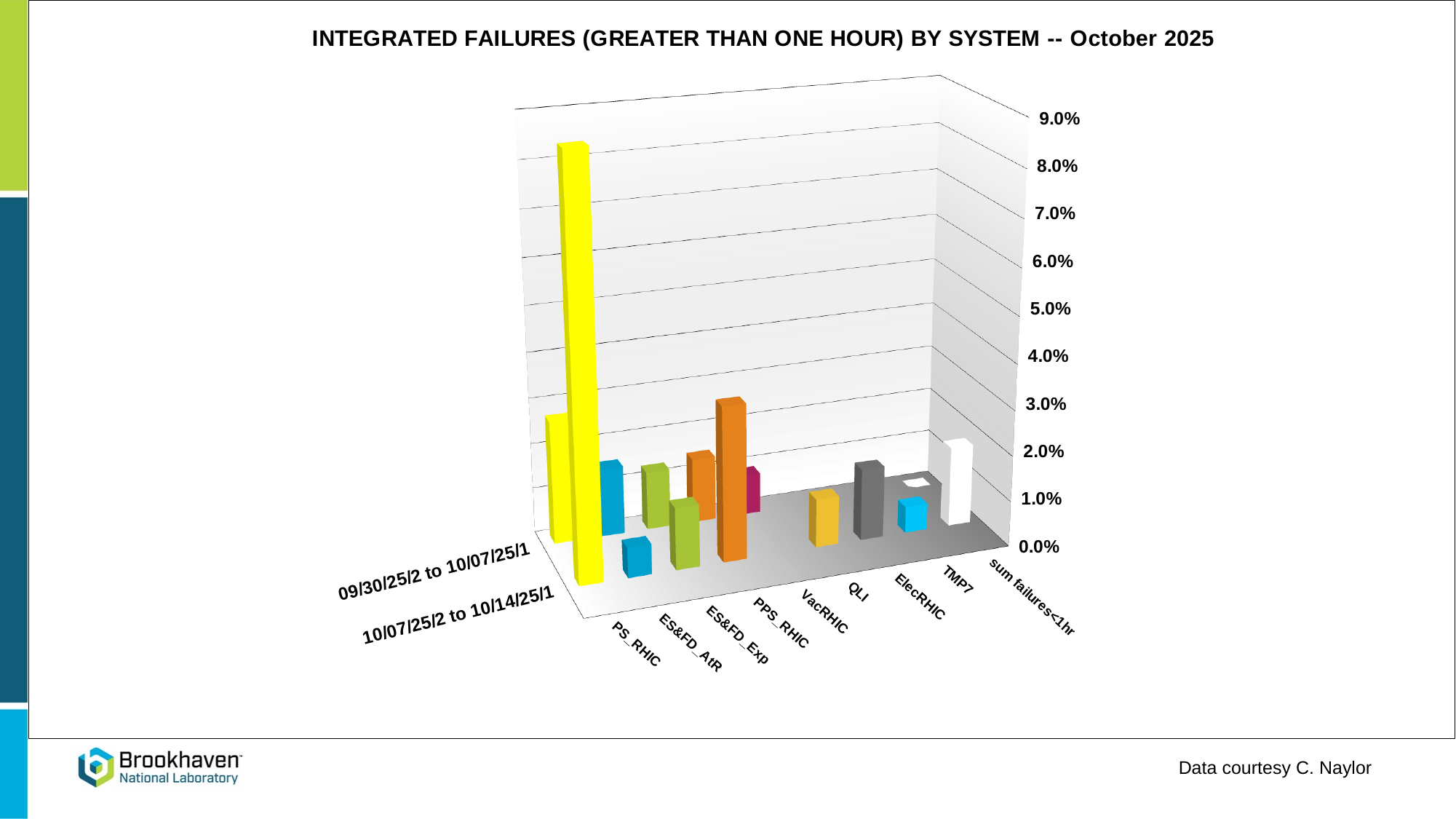
Which system has the tallest bar in the chart? PS_RHIC How many weekly periods (rows) are plotted in the chart? 2 Is the value for PS_RHIC in the 10/07/25/2 to 10/14/25/1 period greater or less than 5.0%? greater Which category is listed last on the x axis? sum failures<1hr Which period has the taller bar for PS_RHIC, 09/30/25/2 to 10/07/25/1 or 10/07/25/2 to 10/14/25/1? 10/07/25/2 to 10/14/25/1 What kind of chart is shown on the slide? bar chart In the 10/07/25/2 to 10/14/25/1 period, which is larger, PPS_RHIC or ES&FD_AtR? PPS_RHIC How many system categories are shown along the x axis? 9 What is the highest value shown on the vertical axis? 9.0% What is the title of the chart? INTEGRATED FAILURES (GREATER THAN ONE HOUR) BY SYSTEM -- October 2025